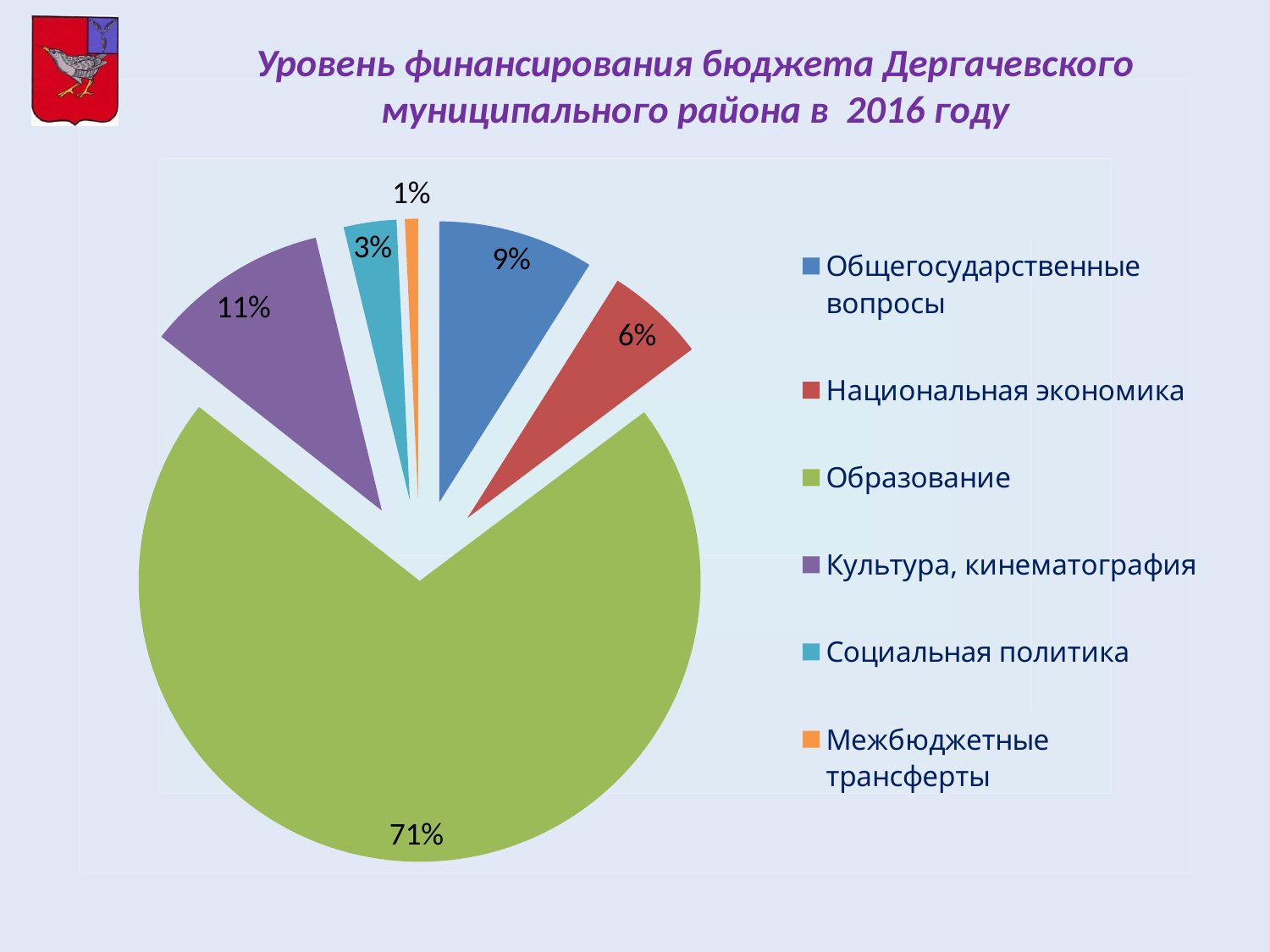
What is the value shown for Национальная экономика? 6% Which category has the smallest slice of the pie? Межбюджетные трансферты What is the value shown for Общегосударственные вопросы? 9% What is the value shown for Межбюджетные трансферты? 1% What is the difference in percentage points between Культура, кинематография and Общегосударственные вопросы? 2% Which is larger: Национальная экономика or Социальная политика? Национальная экономика Which category has the largest slice of the pie? Образование What is the value shown for Культура, кинематография? 11% What type of chart is shown on the slide? Pie chart How many categories does the legend list? 6 What share of the pie does Образование account for? 71% What is the value shown for Социальная политика? 3%